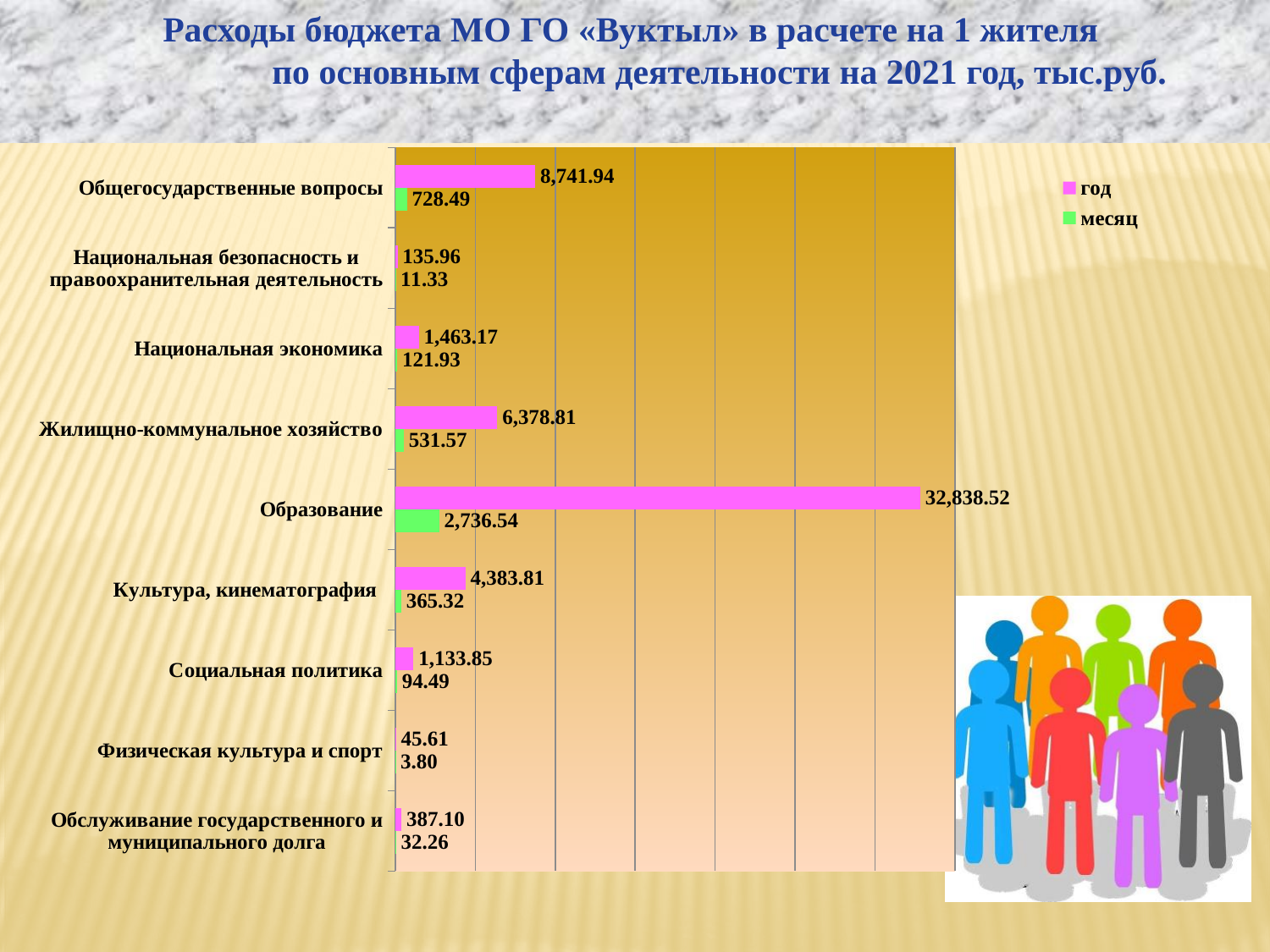
What is the difference between the "год" values for Общегосударственные вопросы and Жилищно-коммунальное хозяйство? 2,363.13 Which category has the highest "год" value? Образование What kind of chart is shown on the slide? Bar chart What is the "год" value for Общегосударственные вопросы? 8,741.94 What is the value of the "месяц" series for Образование? 2,736.54 Which has the larger "год" value: Культура, кинематография or Национальная экономика? Культура, кинематография What is the "месяц" value for Жилищно-коммунальное хозяйство? 531.57 What is the "год" value for Физическая культура и спорт? 45.61 Which category has the lowest "год" value? Физическая культура и спорт How many series does the legend list? 2 What is the value of the "год" series for Образование? 32,838.52 How many categories are shown in the chart? 9